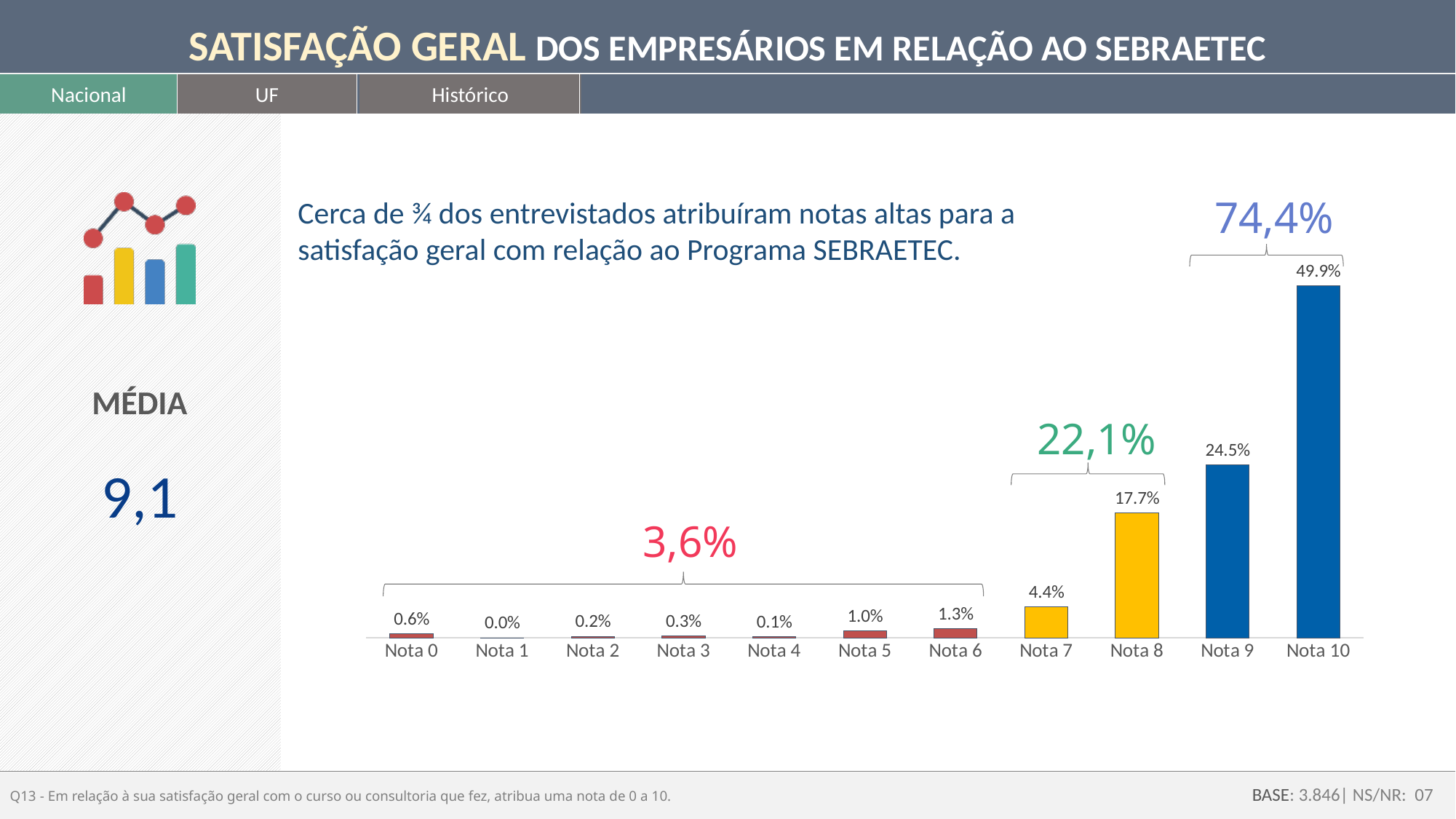
What is the value for Nota 0? 0.6% What is the difference between the values for Nota 10 and Nota 9? 25.4% How many categories are shown on the x axis? 11 Which category has the highest value? Nota 10 What is the value for Nota 8? 17.7% Which is larger, the value for Nota 8 or the value for Nota 9? Nota 9 What combined percentage is shown above the bracket covering Nota 7 and Nota 8? 22,1% What combined percentage is shown above the bracket covering Nota 9 and Nota 10? 74,4% What kind of chart is shown on the slide? Bar chart What is the value for Nota 7? 4.4% What is the value for Nota 10? 49.9% Which category has the lowest value? Nota 1